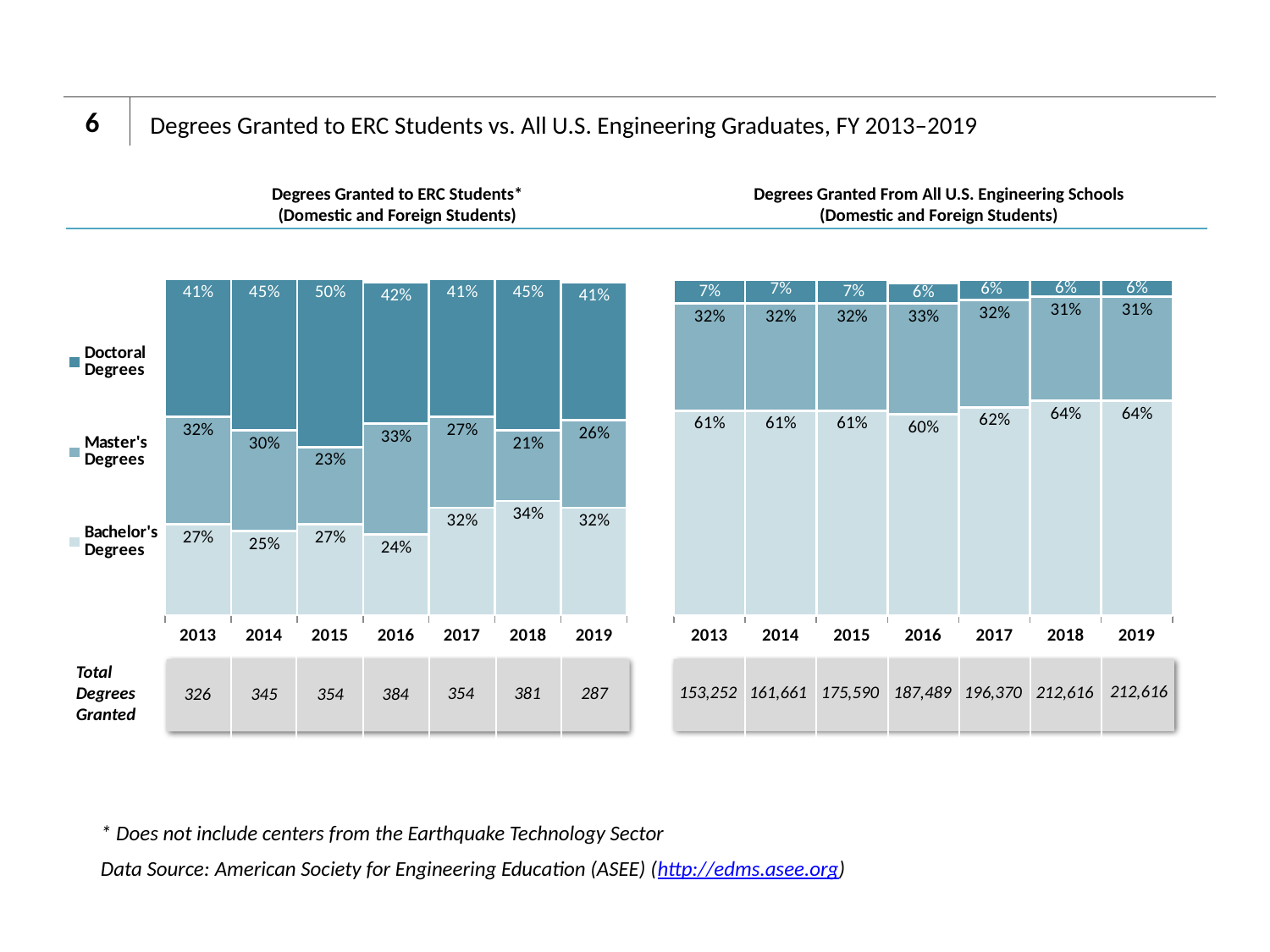
In the 'Degrees Granted to ERC Students' chart, what percentage of degrees in 2015 were Doctoral Degrees? 50% In the 'Degrees Granted to ERC Students' chart, which year has the lowest share of Master's Degrees? 2018 In the 'Degrees Granted to ERC Students' chart, which year has the highest share of Doctoral Degrees? 2015 What kind of chart is the 'Degrees Granted From All U.S. Engineering Schools' chart? Stacked bar chart In the 'Degrees Granted From All U.S. Engineering Schools' chart, does the Bachelor's Degrees share rise or fall from 2016 to 2019? Rise In the 'Degrees Granted From All U.S. Engineering Schools' chart, which is larger in 2017: the Master's Degrees share or the Doctoral Degrees share? Master's Degrees In the 'Degrees Granted From All U.S. Engineering Schools' chart, what percentage of degrees in 2019 were Bachelor's Degrees? 64% In the 'Degrees Granted From All U.S. Engineering Schools' chart, what percentage of degrees in 2016 were Master's Degrees? 33% How many series does the legend list for the charts on this slide? 3 In the 'Degrees Granted to ERC Students' chart, what percentage of degrees in 2018 were Bachelor's Degrees? 34% How many years are shown on the x axis of the 'Degrees Granted to ERC Students' chart? 7 In the 'Degrees Granted to ERC Students' chart, what is the difference between the Doctoral Degrees share in 2015 and in 2013? 9%